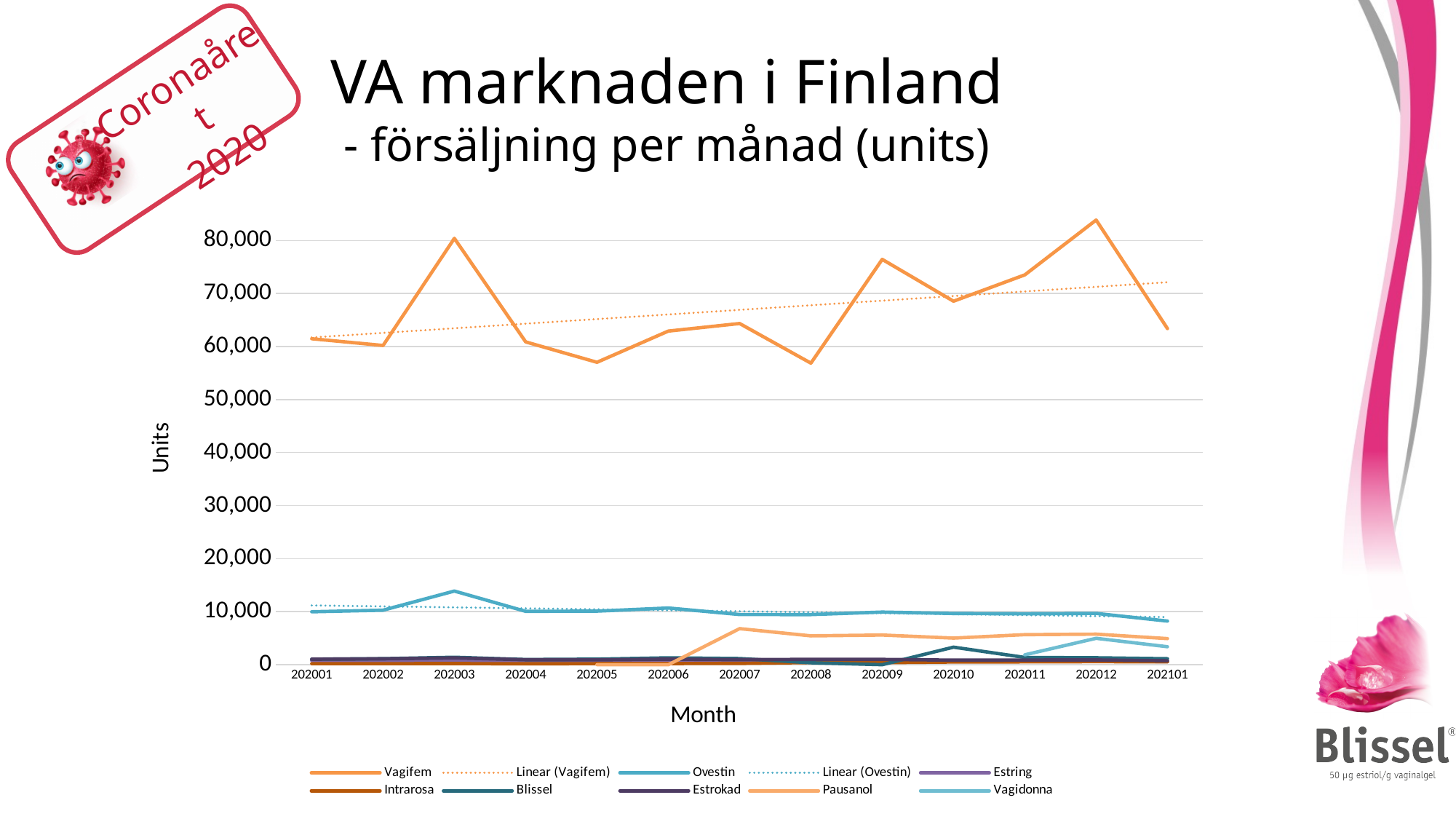
What kind of chart is shown on the slide? line chart Is the value for Ovestin in 202003 greater or less than 10,000? greater Is the value for Vagifem in 202012 greater or less than 80,000? greater Which series has the highest values throughout the chart? Vagifem Which series has the larger value in 202007, Vagifem or Ovestin? Vagifem Is the value for Ovestin in 202101 greater or less than 10,000? less What is the label on the vertical axis of the chart? Units In which month does the Vagifem series reach its highest value? 202012 How many months are plotted along the x axis? 13 Does the Linear (Vagifem) trend line rise or fall from 202001 to 202101? rise How many series does the chart legend list? 10